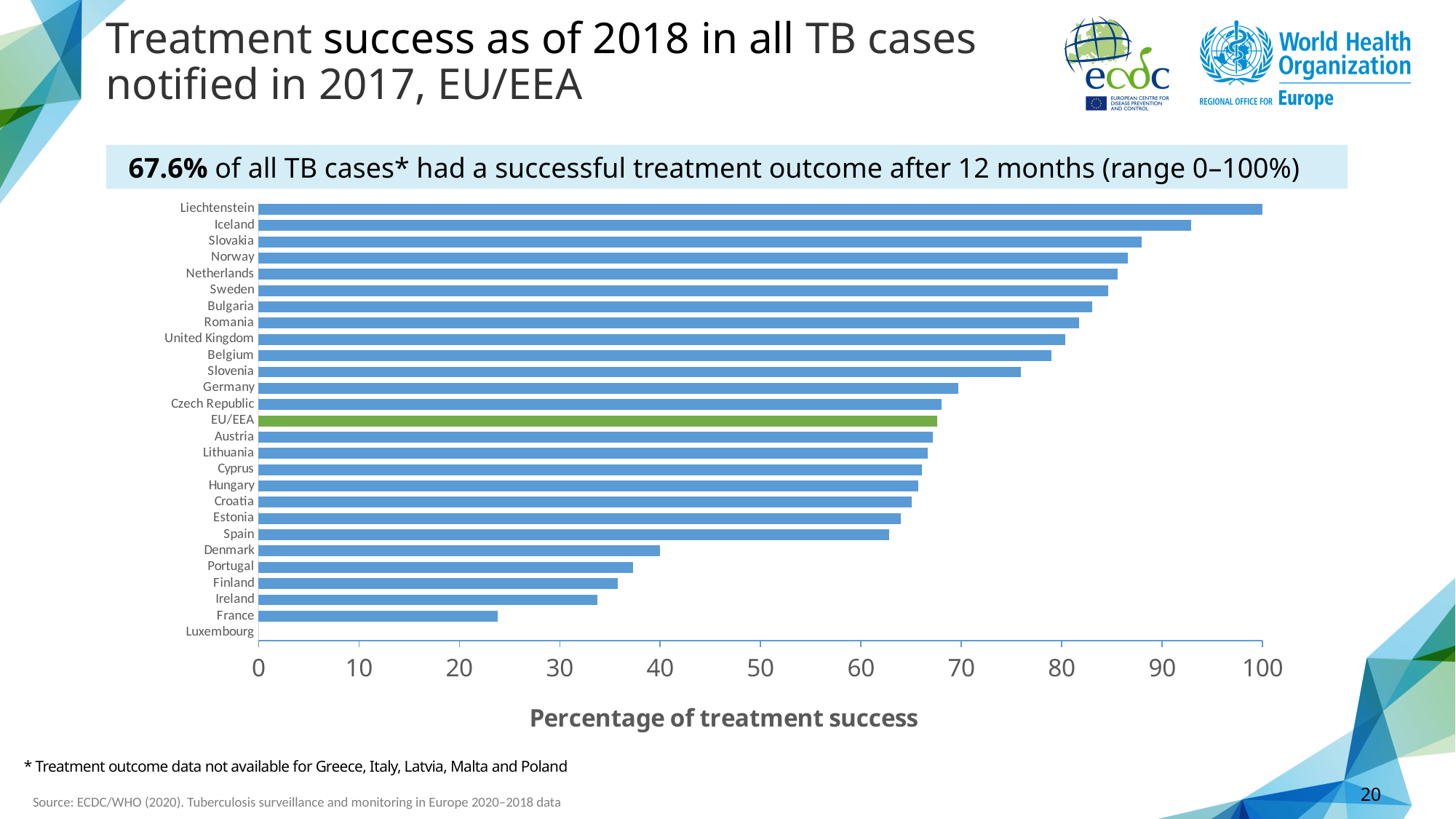
Which category has the lowest percentage of treatment success? Luxembourg Which has a higher percentage of treatment success, Iceland or Slovakia? Iceland Which country has the highest percentage of treatment success? Liechtenstein Which has a higher percentage of treatment success, France or Ireland? Ireland Is the value for Portugal greater or less than 40? less Is the value for Iceland greater or less than 90? greater What is the title of the x axis? Percentage of treatment success What is the percentage of treatment success for EU/EEA? 67.6% What is the percentage of treatment success for Liechtenstein? 100 How many categories are listed on the y axis of the chart? 27 What type of chart is shown on the slide? Bar chart Is the value for France greater or less than 30? less